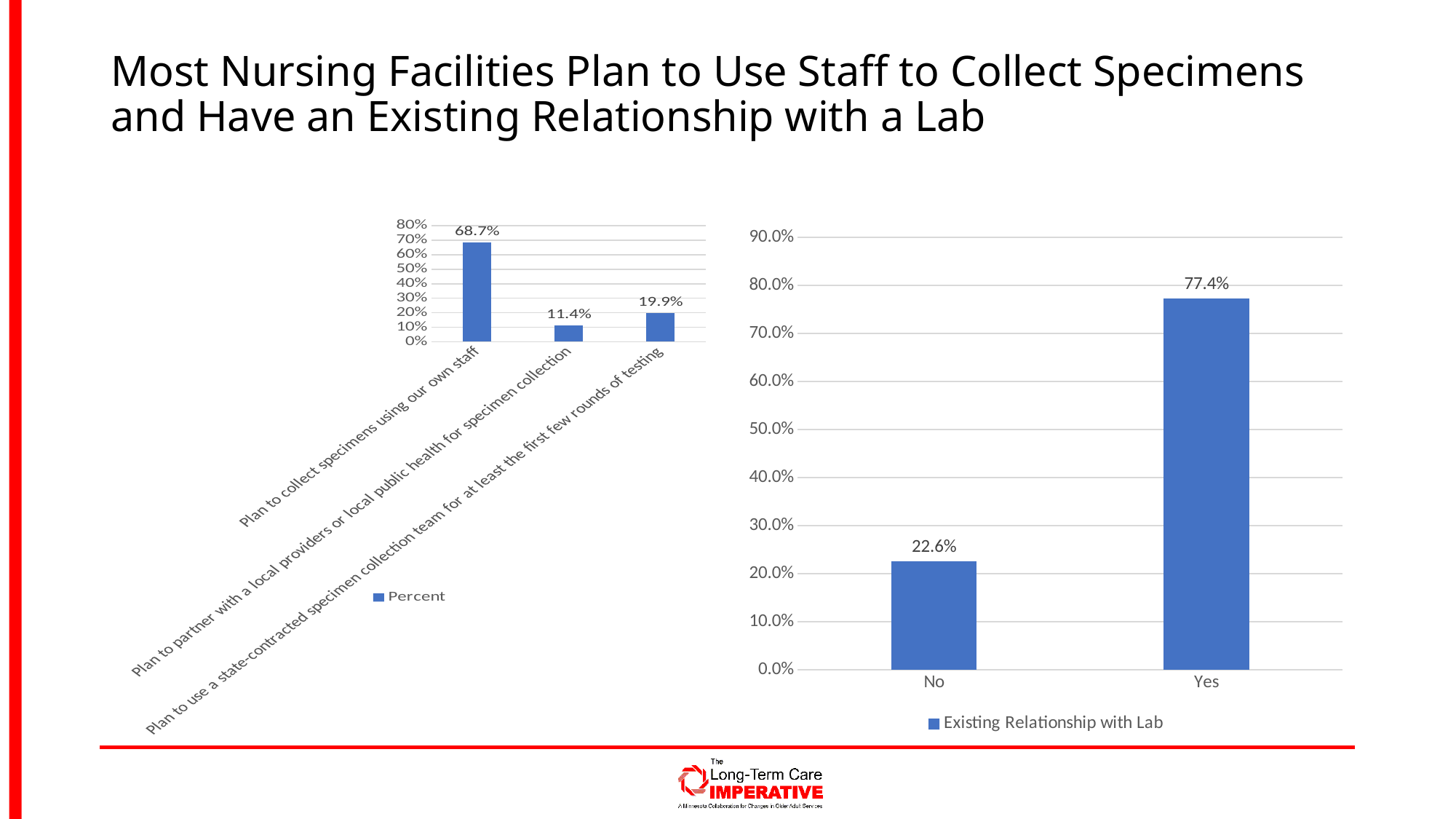
What type of chart is the right chart? Bar chart In the left chart, what is the value for 'Plan to partner with a local providers or local public health for specimen collection'? 11.4% In the right chart, what is the difference between the 'Yes' and 'No' values? 54.8% In the right chart, what is the value for 'Yes'? 77.4% In the left chart, what is the difference between the highest and lowest values? 57.3% In the right chart, what is the value for 'No'? 22.6% What is the legend entry of the right chart? Existing Relationship with Lab In the left chart, which category has the lowest value? Plan to partner with a local providers or local public health for specimen collection In the left chart, how many categories are plotted? 3 In the left chart, what is the value for 'Plan to use a state-contracted specimen collection team for at least the first few rounds of testing'? 19.9% In the right chart, which category is higher, 'No' or 'Yes'? Yes In the left chart, what is the value for 'Plan to collect specimens using our own staff'? 68.7%